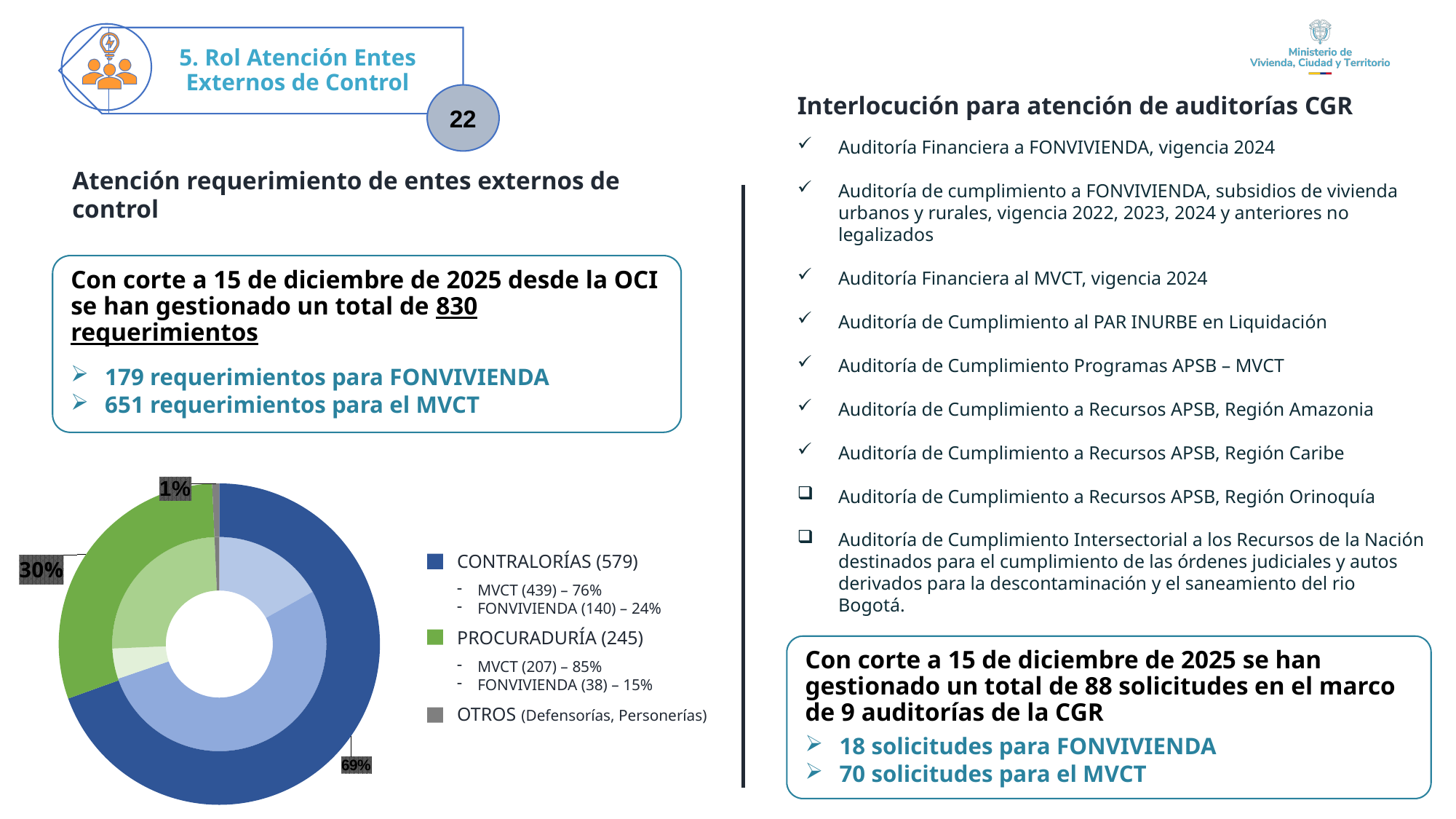
What percentage of the doughnut chart does CONTRALORÍAS represent? 69% What percentage of the doughnut chart does OTROS represent? 1% What is the difference between the CONTRALORÍAS and PROCURADURÍA counts shown in the legend? 334 Which category has the smallest share of the doughnut chart? OTROS How many requerimientos are shown for CONTRALORÍAS in the chart legend? 579 How many categories does the doughnut chart legend list? 3 Which is larger in the doughnut chart, CONTRALORÍAS or PROCURADURÍA? CONTRALORÍAS Which category has the largest share of the doughnut chart? CONTRALORÍAS How many requerimientos are shown for PROCURADURÍA in the chart legend? 245 What kind of chart is shown on the left of the slide? Doughnut chart What percentage of the doughnut chart does PROCURADURÍA represent? 30% What colour represents PROCURADURÍA in the doughnut chart? Green